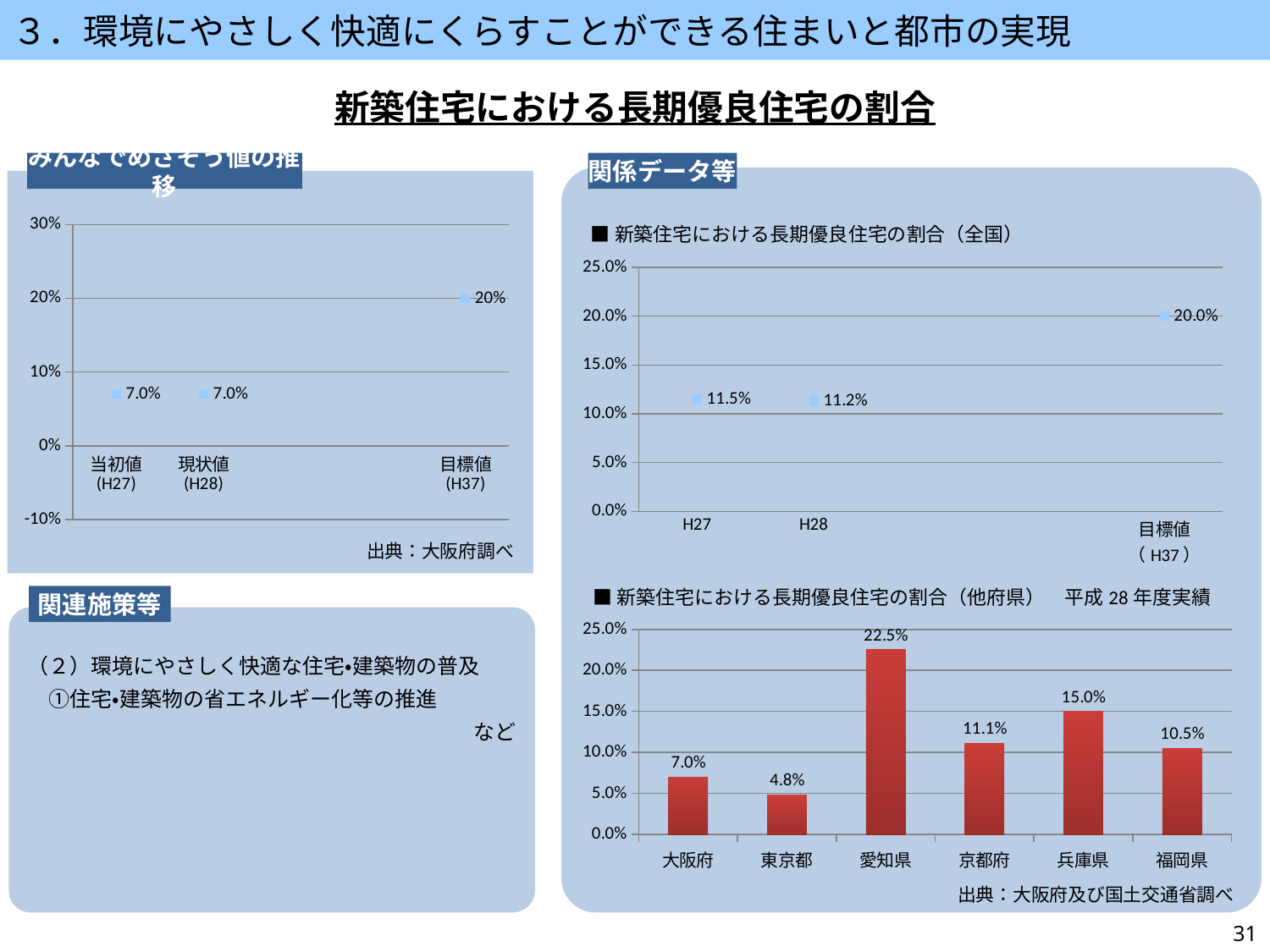
In the bottom-right bar chart (他府県), what is the difference between the values for 兵庫県 and 大阪府? 8.0% In the bottom-right bar chart (他府県), what is the value for 東京都? 4.8% In the top-right chart (新築住宅における長期優良住宅の割合（全国）), what is the value for H27? 11.5% In the bottom-right bar chart (新築住宅における長期優良住宅の割合（他府県）), what is the value for 愛知県? 22.5% In the left chart (みんなでめざそう値の推移), what is the difference between the 目標値 (H37) and the 当初値 (H27)? 13% In the top-right chart (全国), what is the value for 目標値 (H37)? 20.0% In the bottom-right bar chart (他府県), which prefecture has the lowest value? 東京都 What kind of chart is the bottom-right chart (他府県)? bar chart In the bottom-right bar chart (他府県), which is larger, the value for 京都府 or the value for 福岡県? 京都府 In the bottom-right bar chart (他府県), which prefecture has the highest value? 愛知県 In the left chart (みんなでめざそう値の推移), what is the value for 現状値 (H28)? 7.0% How many prefectures are shown in the bottom-right bar chart (他府県)? 6